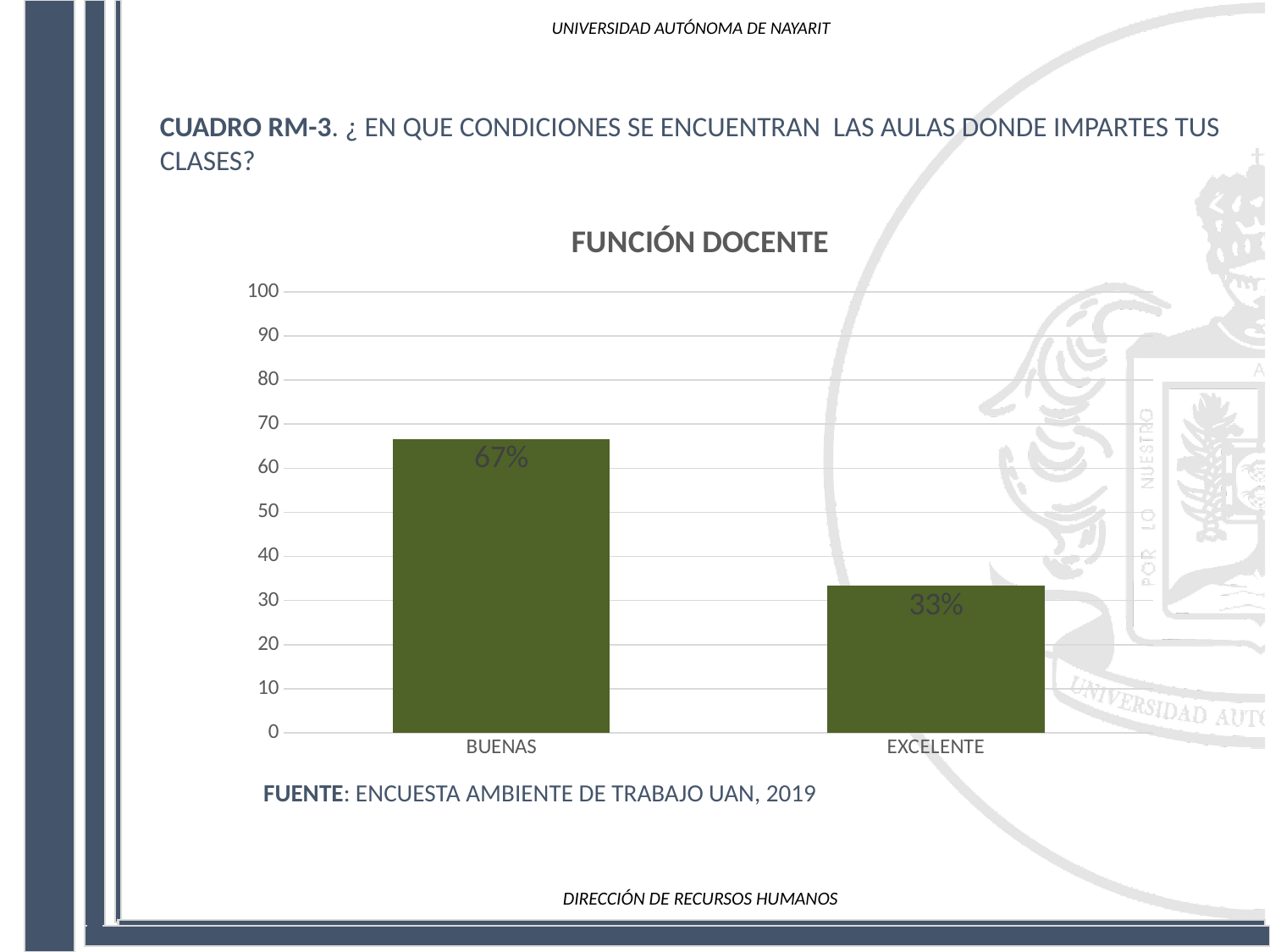
Is the value for EXCELENTE greater or less than 40? less What is the value for BUENAS? 67% Is the value for BUENAS greater or less than 50? greater What is the value for EXCELENTE? 33% What kind of chart is shown? bar chart Which is larger, the value for BUENAS or the value for EXCELENTE? BUENAS What is the highest value shown on the y axis? 100 What is the difference between the values for BUENAS and EXCELENTE? 34% Which category has the lowest value? EXCELENTE Which category has the highest value? BUENAS How many categories are shown on the x axis? 2 What is the title of the chart? FUNCIÓN DOCENTE